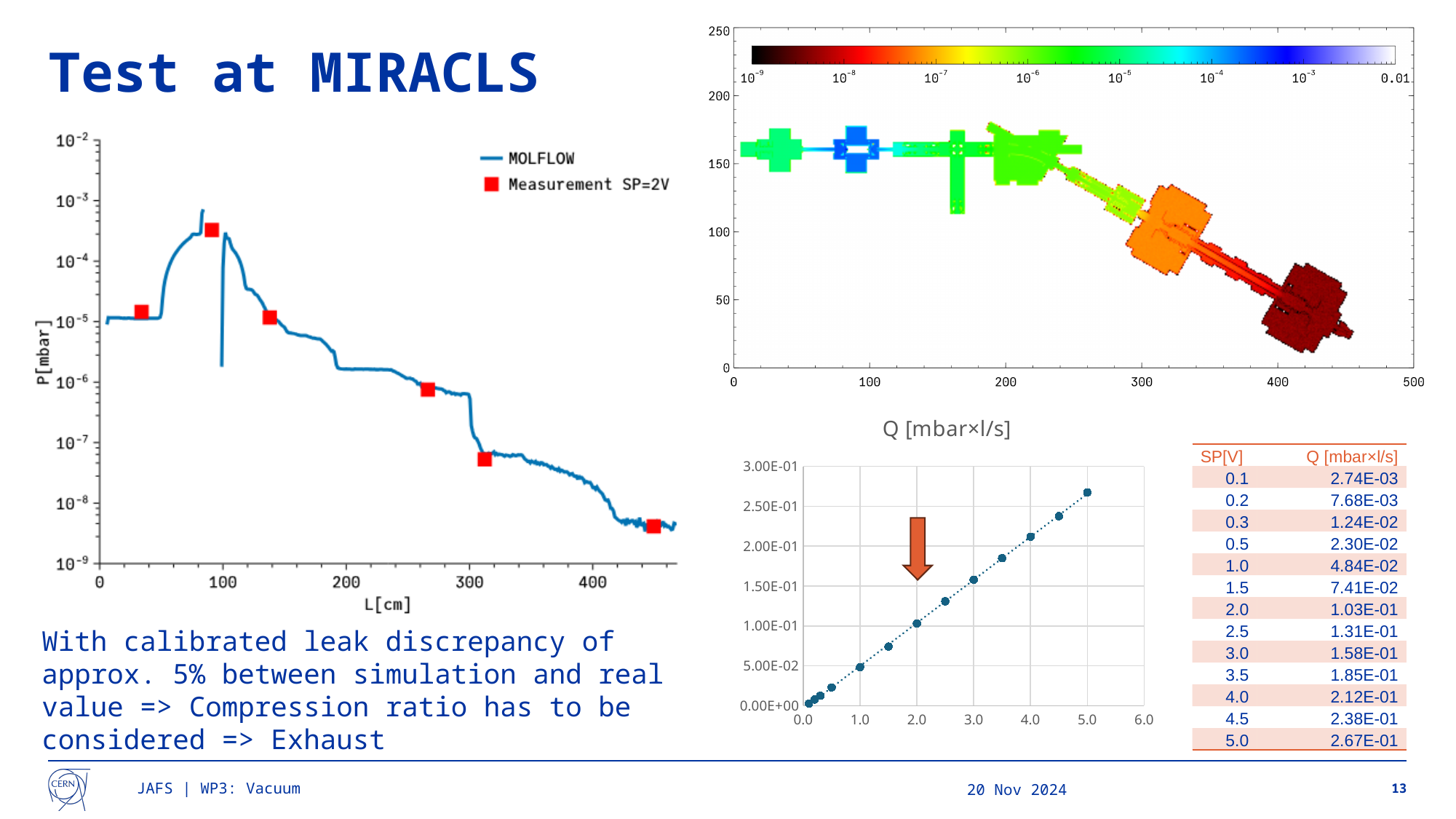
On the bottom-right chart titled Q [mbar×l/s], how many data points are plotted? 13 On the bottom-right chart titled Q [mbar×l/s], which SP value has the highest Q? 5.0 On the left chart (P[mbar] vs L[cm]), how many red measurement points are plotted? 6 On the bottom-right chart titled Q [mbar×l/s], do the values rise or fall as SP increases along the x axis? rise On the bottom-right chart titled Q [mbar×l/s], what kind of chart is it? scatter chart On the bottom-right chart titled Q [mbar×l/s], what is the lowest plotted Q value? 2.74E-03 On the left chart (P[mbar] vs L[cm]), how many entries does the legend list? 2 On the top-right colour map, what are the lowest and highest values shown on the colour scale? 10^-9 and 0.01 On the left chart (P[mbar] vs L[cm]), is the measurement point near L=450 cm greater or less than 10^-8 mbar? less On the left chart (P[mbar] vs L[cm]), is the measurement point near L=90 cm greater or less than 10^-4 mbar? greater On the bottom-right chart titled Q [mbar×l/s], what is the value of Q at SP = 2.0 V? 1.03E-01 On the left chart (P[mbar] vs L[cm]), what are the two legend entries? MOLFLOW and Measurement SP=2V